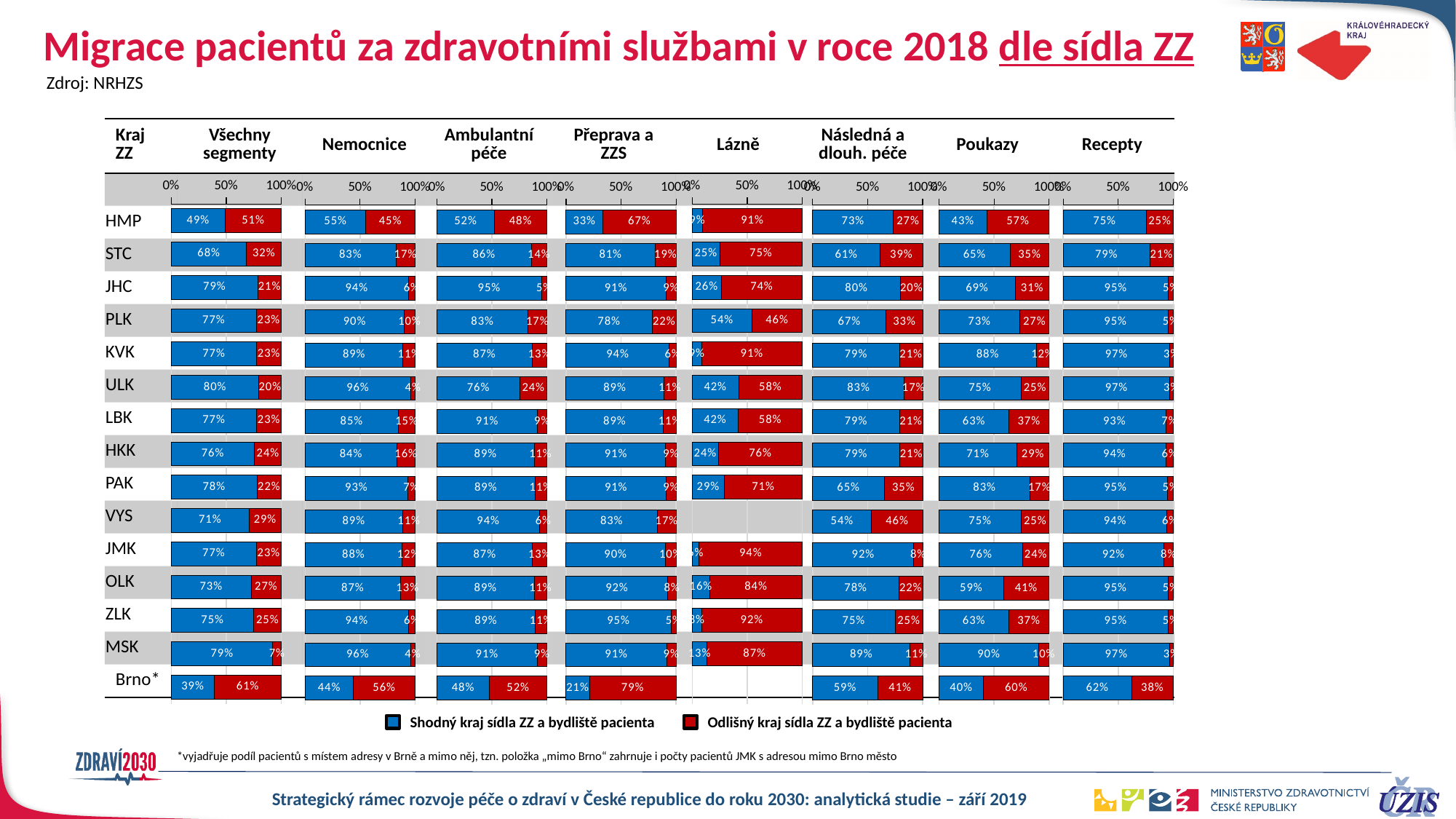
In the Nemocnice chart, what is the difference between the blue and red values for HMP? 10 percentage points In the Recepty chart, what is the red (Odlišný kraj) value for KVK? 3% In the Lázně chart, what is the blue (Shodný kraj) value for PLK? 54% How many rows (regions including Brno*) are shown in each chart? 15 In the Nemocnice chart, what share of HMP patients had the same region of provider and residence (blue segment)? 55% In the Poukazy chart, what is the blue value for MSK? 90% In the Nemocnice chart, which has a larger blue share, STC or JHC? JHC In the Všechny segmenty chart, what is the red value for Brno*? 61% In the Lázně chart, which region has the highest blue (Shodný kraj) share? PLK What type of chart is used for each segment column? Stacked bar chart How many series does the legend list? 2 In the Všechny segmenty chart, which row has the lowest blue (Shodný kraj) share? Brno*